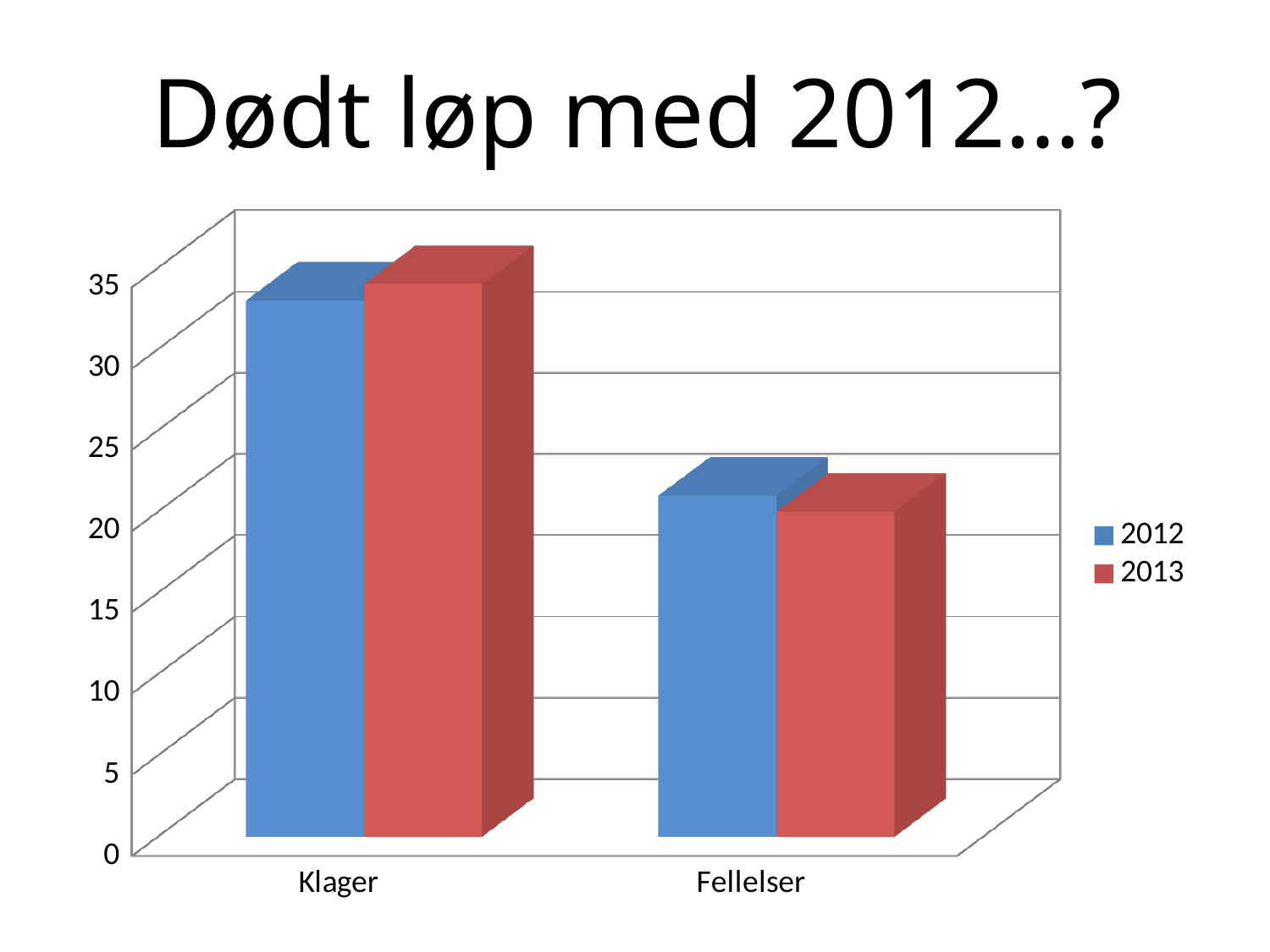
Is the value for Klager in 2012 greater or less than 30? greater Which category has the lowest value for the 2013 series? Fellelser How many series does the legend list? 2 Which category has the highest value for the 2012 series? Klager What kind of chart is shown on the slide? bar chart What is the title of the slide? Dødt løp med 2012...? How many categories are shown on the x axis? 2 Is the value for Klager in 2013 greater or less than 30? greater What are the series listed in the legend? 2012 and 2013 Is the value for Fellelser in 2012 greater or less than 25? less Which is larger for 2013: the value for Klager or the value for Fellelser? Klager